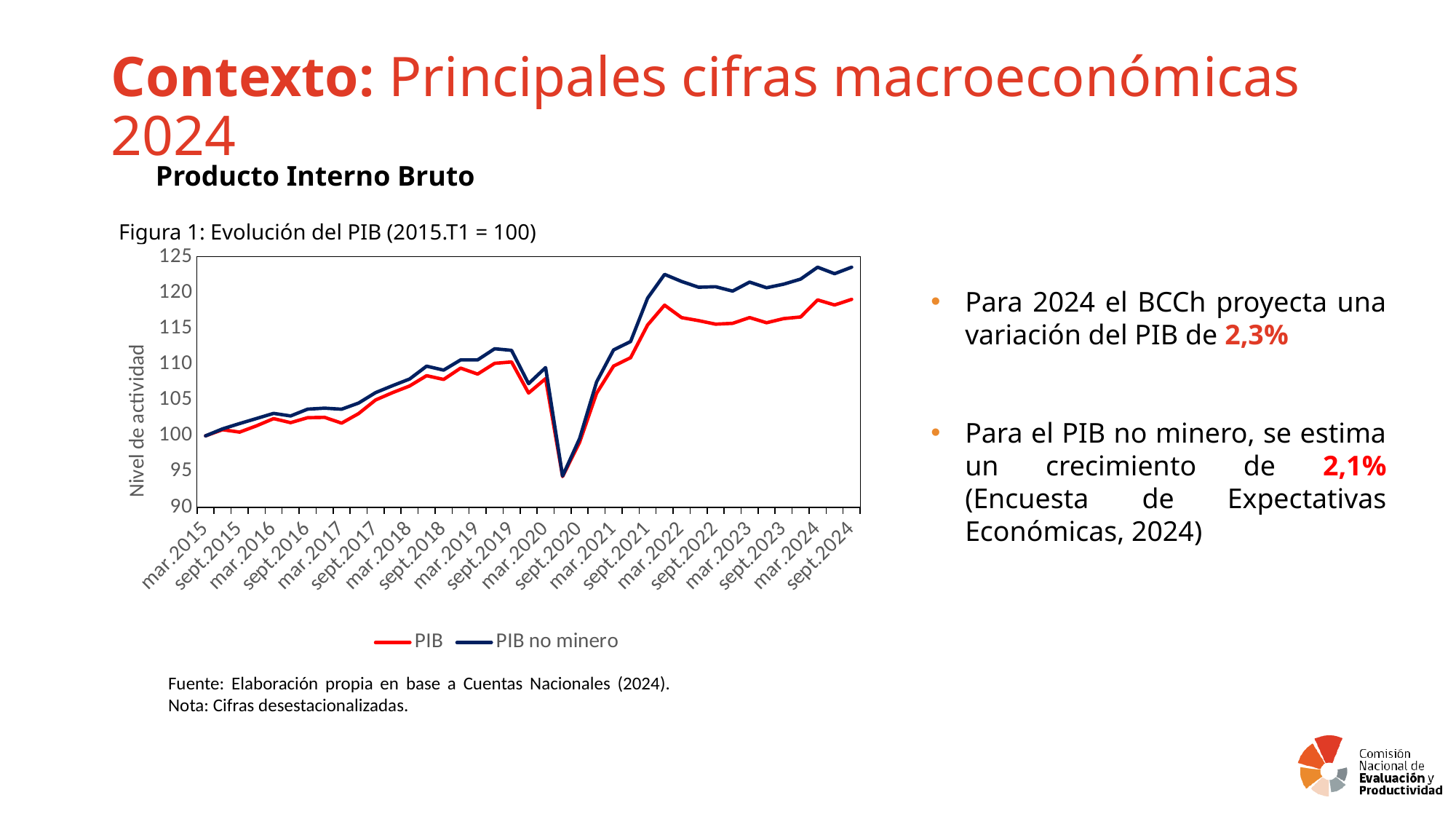
What kind of chart is Figura 1: Evolución del PIB? Line chart How many series does the legend of the chart list? 2 Is the value of PIB no minero at mar.2022 greater or less than 120? greater Is the value of PIB at sept.2024 greater or less than 115? greater What is the label of the vertical axis of the chart? Nivel de actividad At sept.2024, which series is higher, PIB or PIB no minero? PIB no minero Does the PIB series rise or fall between mar.2015 and sept.2019? Rise Is the value of PIB no minero at sept.2024 greater or less than 120? greater Does the PIB no minero series rise or fall between mar.2020 and sept.2020? Fall What are the two series shown in the legend of the chart? PIB and PIB no minero